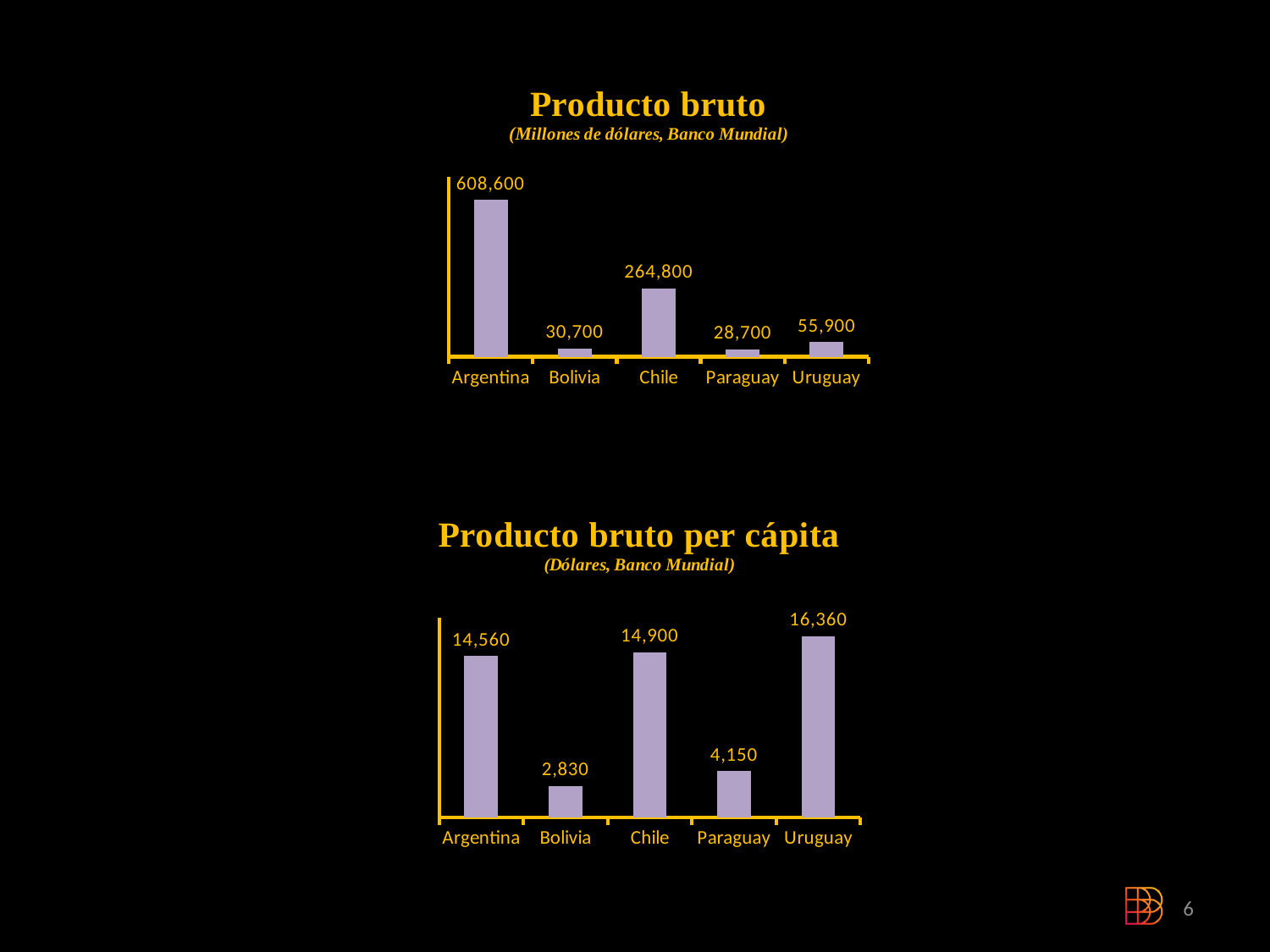
In the 'Producto bruto per cápita' chart, what is the value for Bolivia? 2,830 How many countries are shown in the 'Producto bruto per cápita' chart? 5 In the 'Producto bruto per cápita' chart, what is the value for Uruguay? 16,360 In the 'Producto bruto' chart, what is the value for Paraguay? 28,700 In the 'Producto bruto per cápita' chart, what is the difference between the values for Chile and Paraguay? 10,750 In the 'Producto bruto' chart, which country has the highest value? Argentina In the 'Producto bruto' chart, which is larger, the value for Uruguay or the value for Bolivia? Uruguay In the 'Producto bruto' chart, what is the value for Argentina? 608,600 In the 'Producto bruto' chart, which country has the lowest value? Paraguay In the 'Producto bruto per cápita' chart, which country has the highest value? Uruguay In the 'Producto bruto per cápita' chart, which country has the lowest value? Bolivia In the 'Producto bruto' chart, what is the difference between the values for Argentina and Chile? 343,800